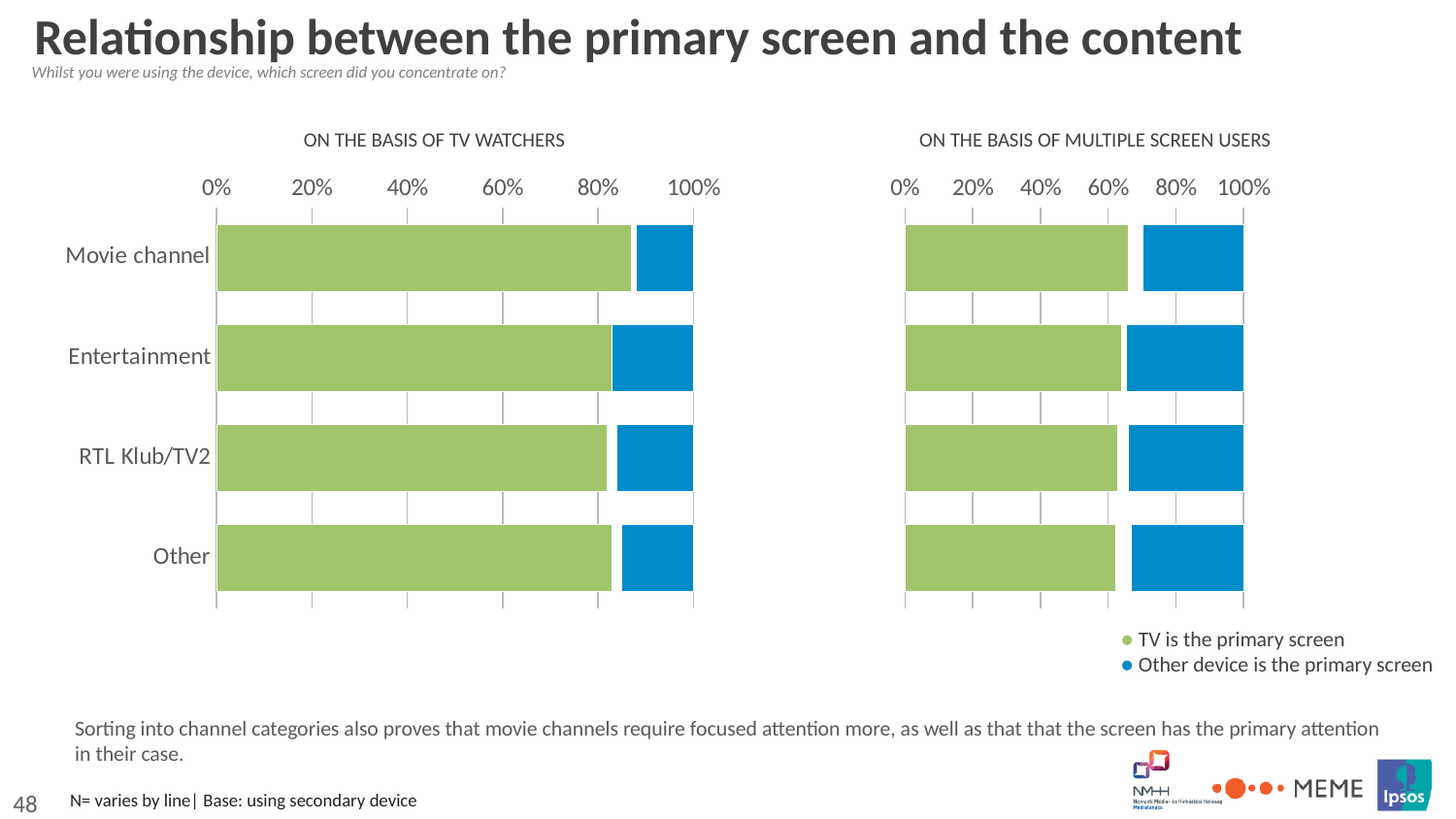
In the 'ON THE BASIS OF MULTIPLE SCREEN USERS' chart, is the 'TV is the primary screen' value for RTL Klub/TV2 greater or less than 80%? less In the 'ON THE BASIS OF TV WATCHERS' chart, which category has the highest 'TV is the primary screen' value? Movie channel What kind of chart is the 'ON THE BASIS OF TV WATCHERS' chart? bar chart In the 'ON THE BASIS OF TV WATCHERS' chart, which is larger for 'TV is the primary screen': Movie channel or RTL Klub/TV2? Movie channel How many channel categories are shown on the 'ON THE BASIS OF TV WATCHERS' chart? 4 In the 'ON THE BASIS OF TV WATCHERS' chart, is the 'TV is the primary screen' value for Other greater or less than 80%? greater In the 'ON THE BASIS OF MULTIPLE SCREEN USERS' chart, is the 'TV is the primary screen' value for Movie channel greater or less than 80%? less What is the title of the chart on the right side of the slide? ON THE BASIS OF MULTIPLE SCREEN USERS Which colour represents 'Other device is the primary screen' in the charts? blue How many series does the legend list for the charts on this slide? 2